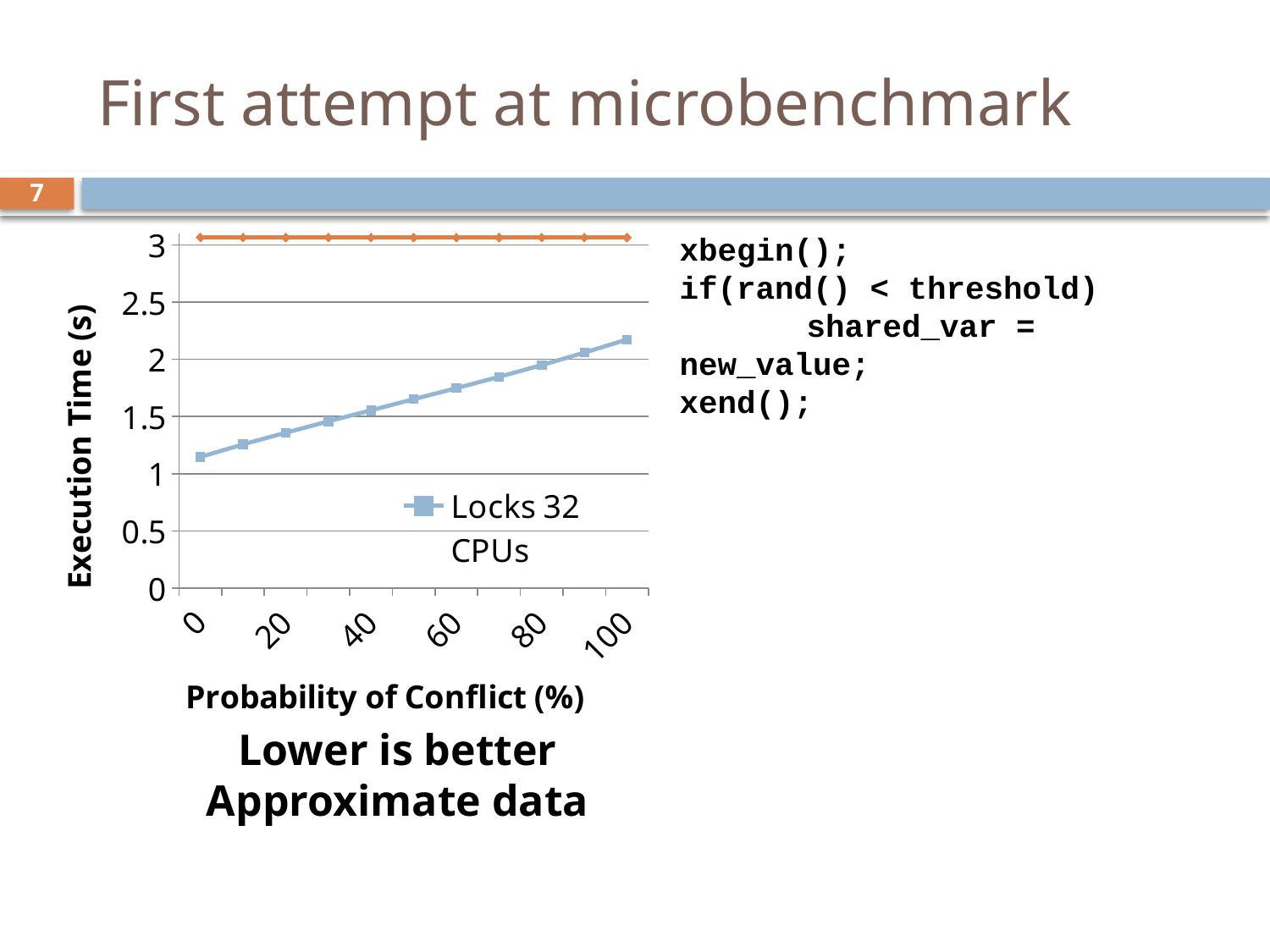
At 100% probability of conflict, which line has the higher execution time, Locks 32 CPUs or the orange line? the orange line Is the execution time for Locks 32 CPUs at 0% probability of conflict greater or less than 1.5? less Is the execution time for Locks 32 CPUs at 100% probability of conflict greater or less than 2? greater What is the title of the y axis? Execution Time (s) Is the orange line's execution time greater or less than 2.5? greater How many data points are plotted on the Locks 32 CPUs line? 11 What kind of chart is shown on the slide? line chart At which probability of conflict is the execution time for Locks 32 CPUs highest? 100 How does the execution time for Locks 32 CPUs change as the probability of conflict increases from 0 to 100? it rises At which probability of conflict is the execution time for Locks 32 CPUs lowest? 0